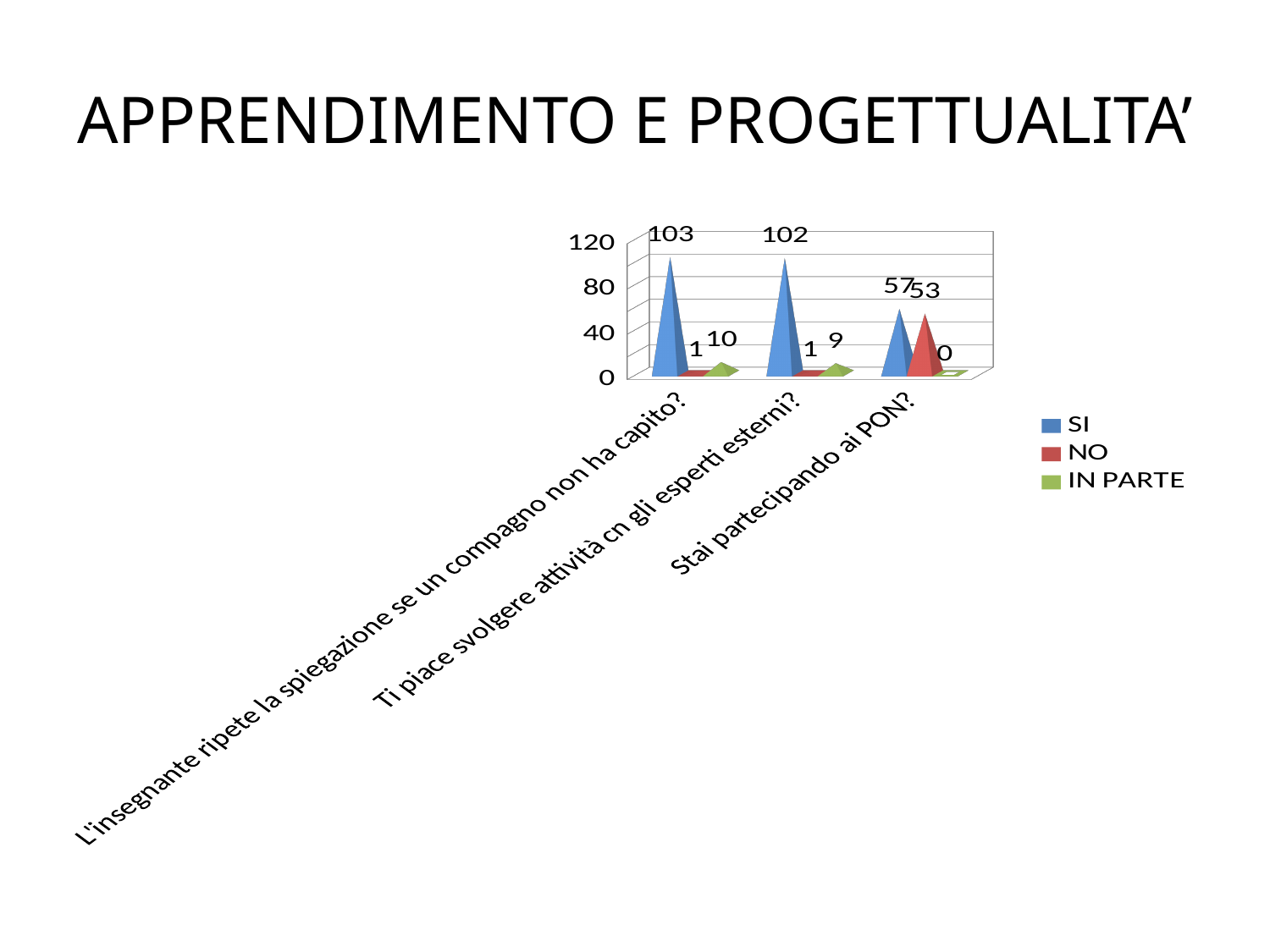
What is the difference between the SI and NO values for "Stai partecipando ai PON?"? 4 What is the value for IN PARTE for the question "Stai partecipando ai PON?"? 0 What is the value for IN PARTE for the question "Ti piace svolgere attività cn gli esperti esterni?"? 9 For "Stai partecipando ai PON?", which is larger, the SI value or the NO value? SI What is the value for SI for the question "L'insegnante ripete la spiegazione se un compagno non ha capito?"? 103 Which question has the highest SI value? L'insegnante ripete la spiegazione se un compagno non ha capito? Which question has the lowest SI value? Stai partecipando ai PON? How many series does the chart legend list? 3 What kind of chart is shown on the slide? Bar chart How many questions (categories) are shown on the x axis of the chart? 3 What is the value for NO for the question "Stai partecipando ai PON?"? 53 Which colour represents the NO series in the chart? Red